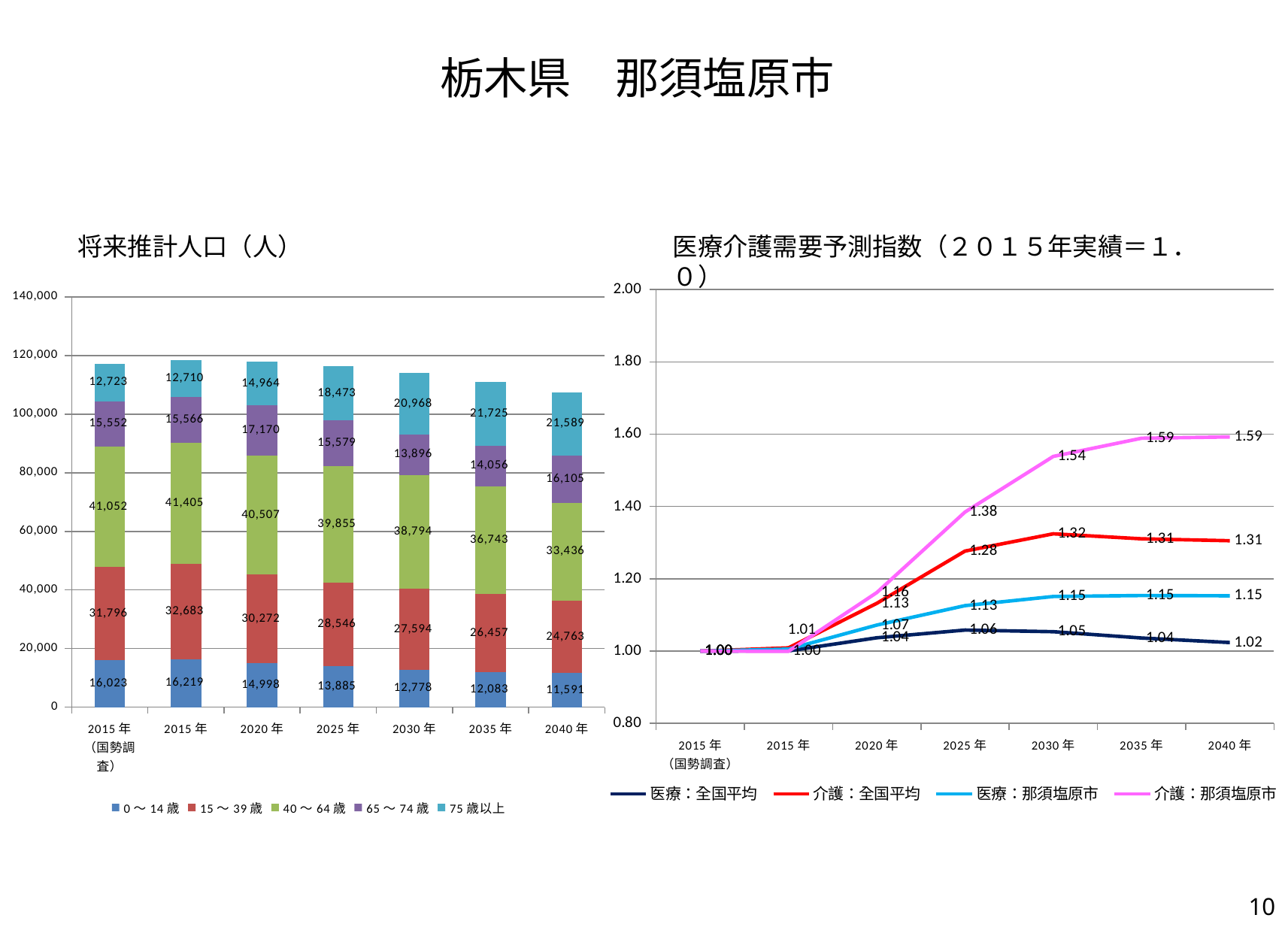
What kind of chart is the 医療介護需要予測指数 chart on the right? line chart What kind of chart is the 将来推計人口（人） chart on the left? bar chart In the 将来推計人口（人） chart, what is the difference between the 40～64歳 value in 2015年 and in 2040年? 7,969 In the 将来推計人口（人） chart, what is the value for 0～14歳 in 2015年（国勢調査）? 16,023 In the 医療介護需要予測指数 chart, which is larger in 2040年: 医療：那須塩原市 or 医療：全国平均? 医療：那須塩原市 In the 医療介護需要予測指数 chart, which series has the highest value in 2040年? 介護：那須塩原市 How many series does the legend of the 将来推計人口（人） chart list? 5 How many series does the legend of the 医療介護需要予測指数 chart list? 4 In the 医療介護需要予測指数 chart, what is the value for 介護：那須塩原市 in 2040年? 1.59 In the 将来推計人口（人） chart, does the 0～14歳 value rise or fall from 2015年 to 2040年? fall In the 将来推計人口（人） chart, what is the total of the stacked bar for 2040年? 107,484 In the 将来推計人口（人） chart, what is the value for 75歳以上 in 2040年? 21,589